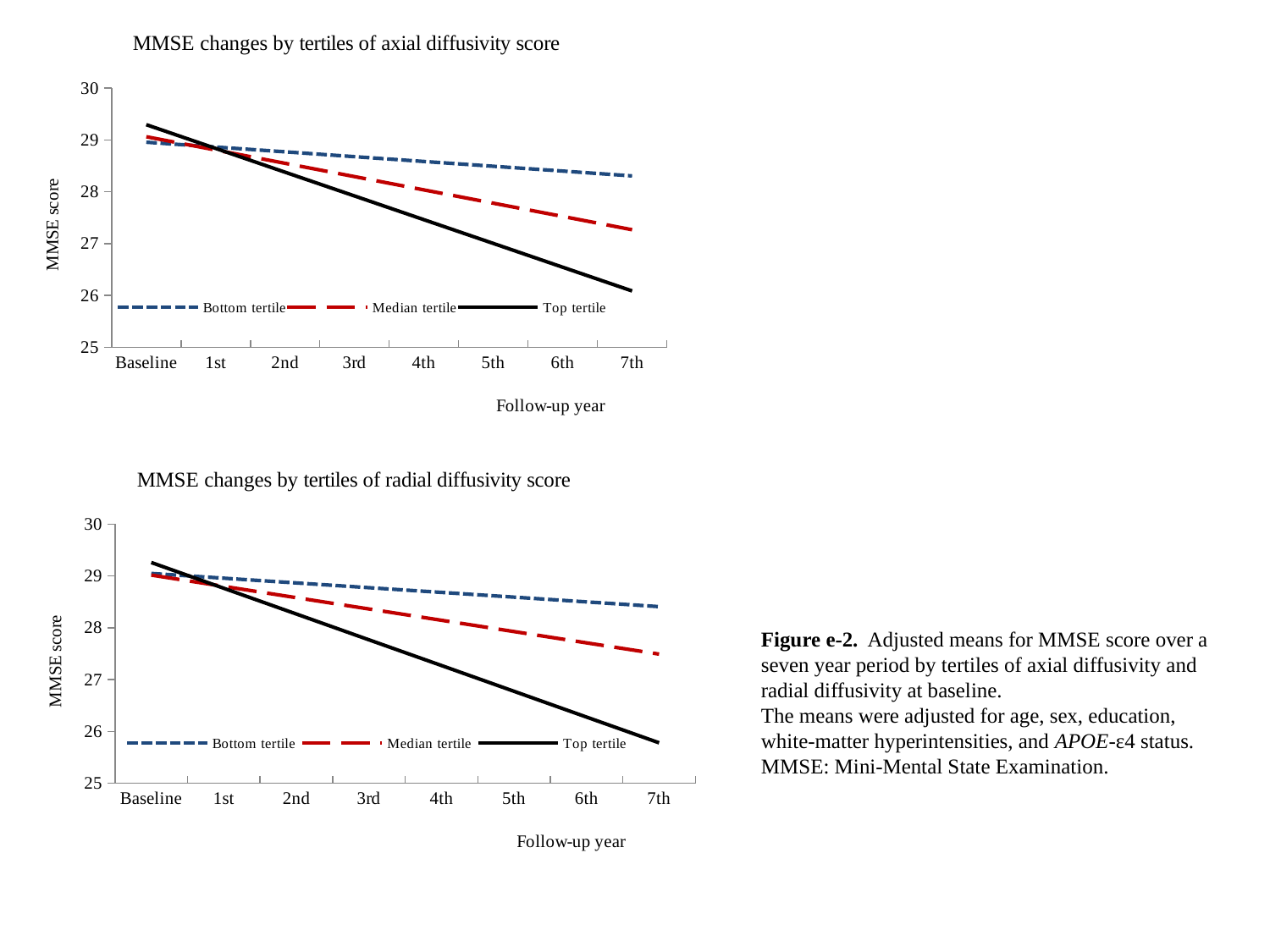
In the bottom chart (radial diffusivity), which tertile has the highest MMSE score at the 7th follow-up year? Bottom tertile In the top chart (axial diffusivity), is the Bottom tertile value at the 7th follow-up year greater or less than 28? greater What is the title of the top chart on the slide? MMSE changes by tertiles of axial diffusivity score In the top chart (axial diffusivity), which tertile has the lowest MMSE score at the 7th follow-up year? Top tertile In the top chart (axial diffusivity), is the Top tertile value at the 7th follow-up year greater or less than 27? less What is the label of the y axis on the bottom chart (radial diffusivity)? MMSE score In the bottom chart (radial diffusivity), is the Top tertile value at the 7th follow-up year greater or less than 26? less In the bottom chart (radial diffusivity), at the 7th follow-up year, is the Median tertile value larger or smaller than the Top tertile value? larger How many follow-up time points are shown on the x axis of the bottom chart (radial diffusivity)? 8 What kind of chart is the top chart, 'MMSE changes by tertiles of axial diffusivity score'? line chart In the top chart (axial diffusivity), does the Top tertile line rise or fall from Baseline to the 7th follow-up year? fall How many series does the legend of the top chart (axial diffusivity) list? 3